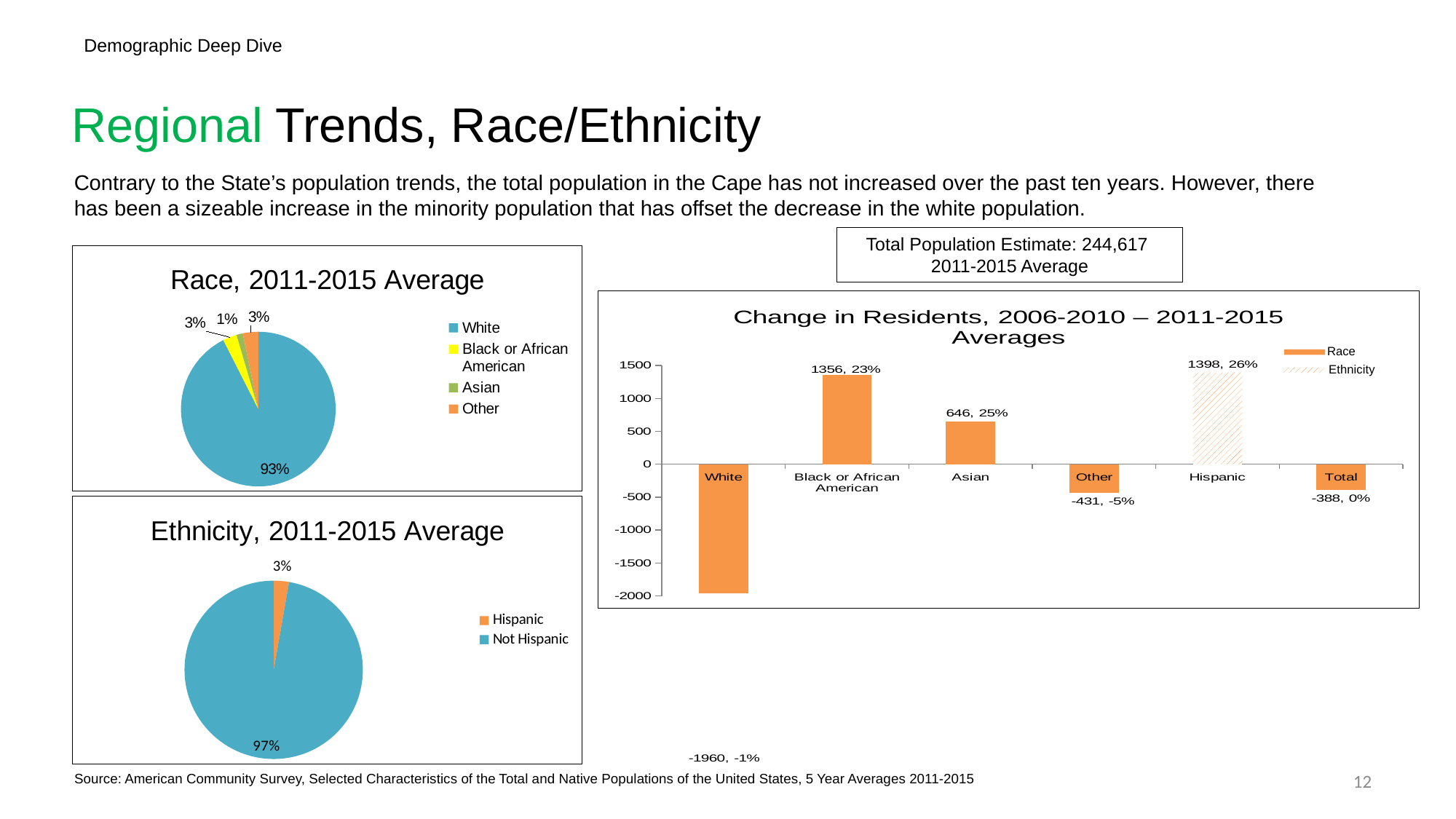
In the 'Change in Residents' bar chart, what percentage change is shown for Asian? 25% In the 'Race, 2011-2015 Average' pie chart, what share is White? 93% In the 'Ethnicity, 2011-2015 Average' pie chart, what share is Not Hispanic? 97% In the 'Change in Residents' bar chart, what is the change in residents for Black or African American? 1356 In the 'Ethnicity, 2011-2015 Average' pie chart, what share is Hispanic? 3% In the 'Change in Residents' bar chart, which is larger, the value for Asian or the value for Other? Asian What kind of chart is the 'Change in Residents, 2006-2010 – 2011-2015 Averages' chart? Bar chart In the 'Race, 2011-2015 Average' pie chart, how many slices are there? 4 In the 'Change in Residents' bar chart, which category has the lowest value? White In the 'Change in Residents' bar chart, how many series does the legend list? 2 In the 'Change in Residents' bar chart, what is the difference between the Hispanic value and the Black or African American value? 42 In the 'Change in Residents' bar chart, which category has the highest value? Hispanic